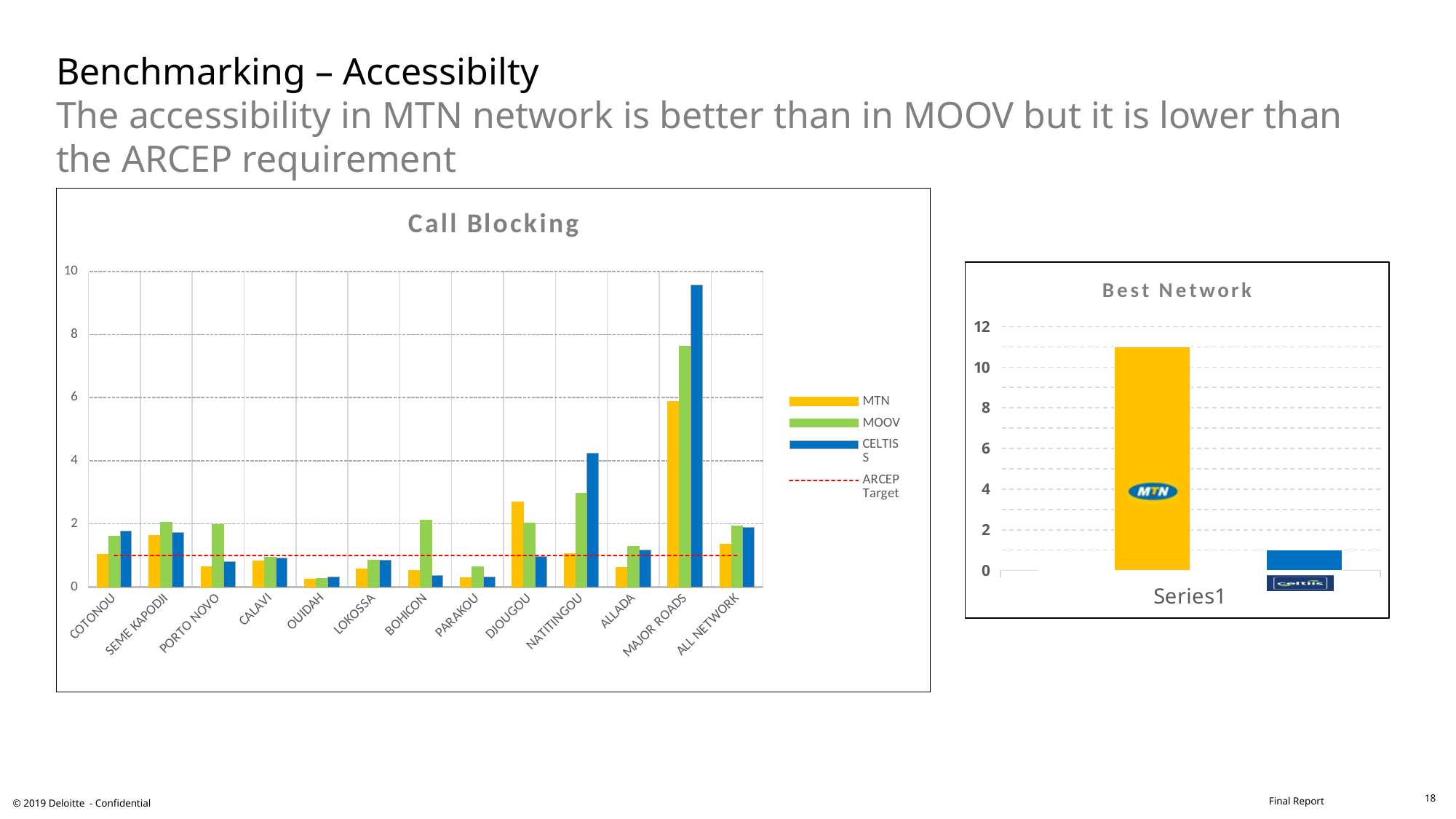
In the Call Blocking chart, what colour is the MTN series? yellow In the Call Blocking chart, which is larger for NATITINGOU, the CELTISS value or the MOOV value? CELTISS In the Call Blocking chart, is the MOOV value for MAJOR ROADS greater or less than 6? greater In the Best Network chart, is the MTN bar greater or less than 10? greater How many entries does the legend of the Call Blocking chart list? 4 In the Call Blocking chart, is the MTN value for MAJOR ROADS greater or less than 4? greater In the Best Network chart, which bar is taller, MTN or Celtis? MTN What kind of chart is the Call Blocking chart? combination bar and line chart In the Call Blocking chart, which is larger for DJOUGOU, the MTN value or the MOOV value? MTN In the Call Blocking chart, which category has the highest CELTISS value? MAJOR ROADS How many categories are shown on the x axis of the Call Blocking chart? 13